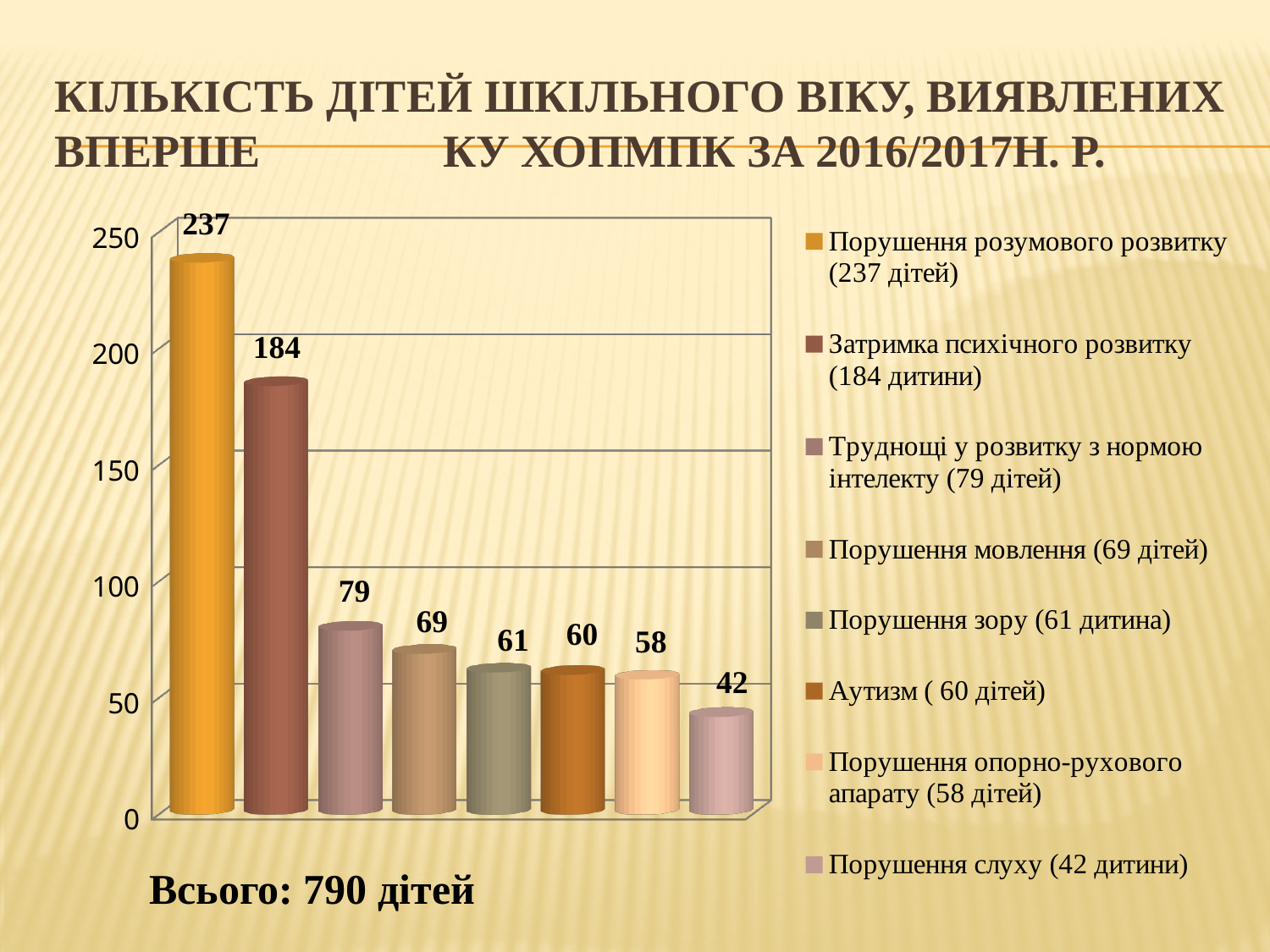
Is the value for Аутизм greater or less than 100? less How many bars are plotted in the chart? 8 What total number of children is stated below the chart? 790 дітей Which is larger, the value for Труднощі у розвитку з нормою інтелекту or the value for Порушення зору? Труднощі у розвитку з нормою інтелекту What kind of chart is shown on the slide? bar chart What is the value for Порушення мовлення? 69 What is the value for Порушення слуху? 42 What is the difference between the values for Порушення розумового розвитку and Затримка психічного розвитку? 53 Which category has the lowest value? Порушення слуху What is the value for Затримка психічного розвитку? 184 Which category has the highest value? Порушення розумового розвитку What is the value for Порушення розумового розвитку? 237